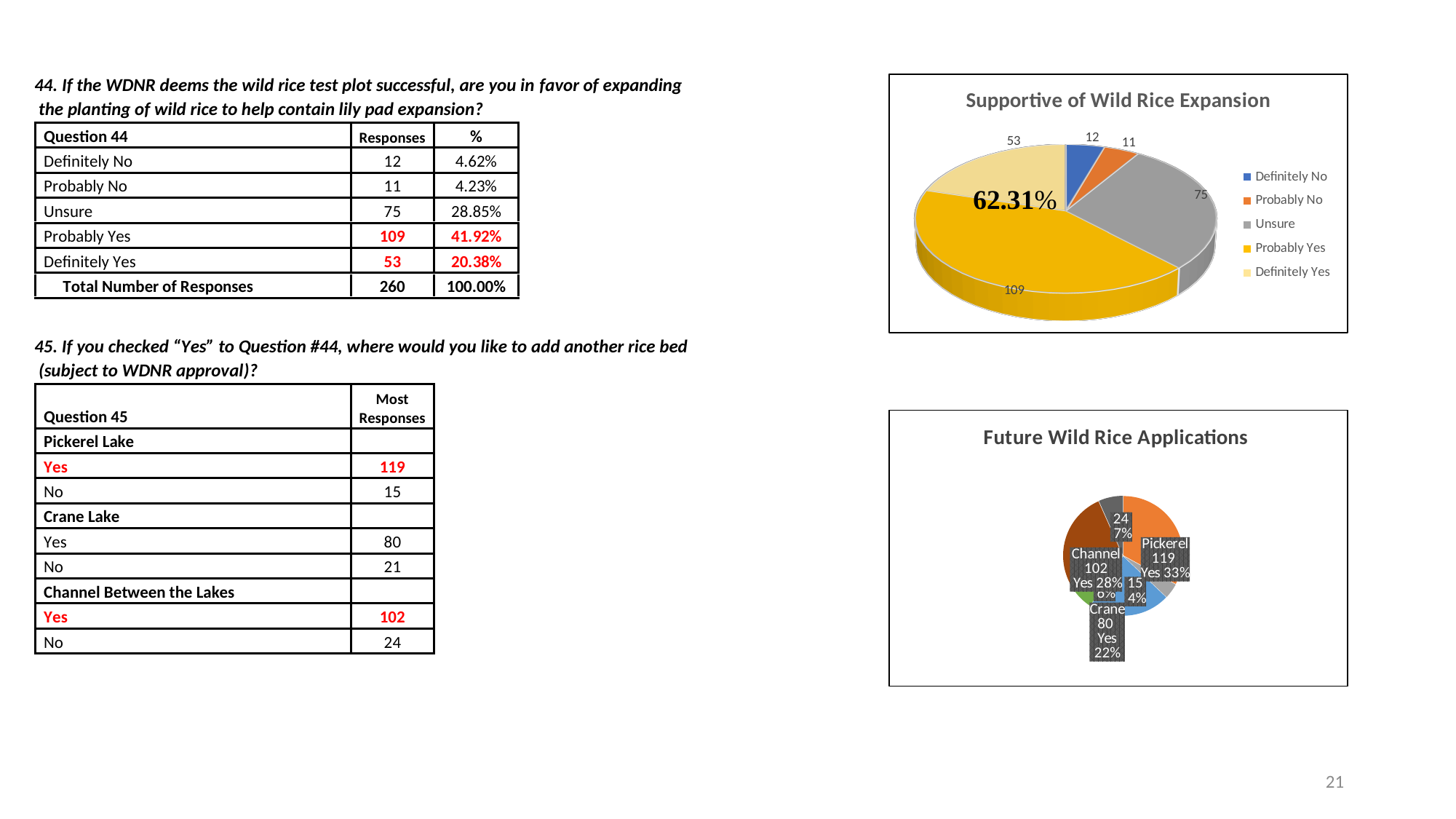
In the 'Supportive of Wild Rice Expansion' chart, what is the difference between the Probably Yes and Unsure values? 34 In the 'Future Wild Rice Applications' chart, what value is shown for Channel Yes? 102 In the 'Supportive of Wild Rice Expansion' chart, what value is shown for Definitely Yes? 53 How many categories does the legend of the 'Supportive of Wild Rice Expansion' chart list? 5 What kind of chart is 'Supportive of Wild Rice Expansion'? Pie chart In the 'Supportive of Wild Rice Expansion' chart, what value is shown for Probably Yes? 109 In the 'Future Wild Rice Applications' chart, what share is shown for Pickerel Yes? 33% What percentage is printed in large text on the 'Supportive of Wild Rice Expansion' chart? 62.31% In the 'Supportive of Wild Rice Expansion' chart, which category has the largest slice? Probably Yes In the 'Supportive of Wild Rice Expansion' chart, which category has the smallest slice? Probably No In the 'Supportive of Wild Rice Expansion' chart, which is larger, Definitely No or Definitely Yes? Definitely Yes In the 'Supportive of Wild Rice Expansion' chart, what value is shown for Unsure? 75